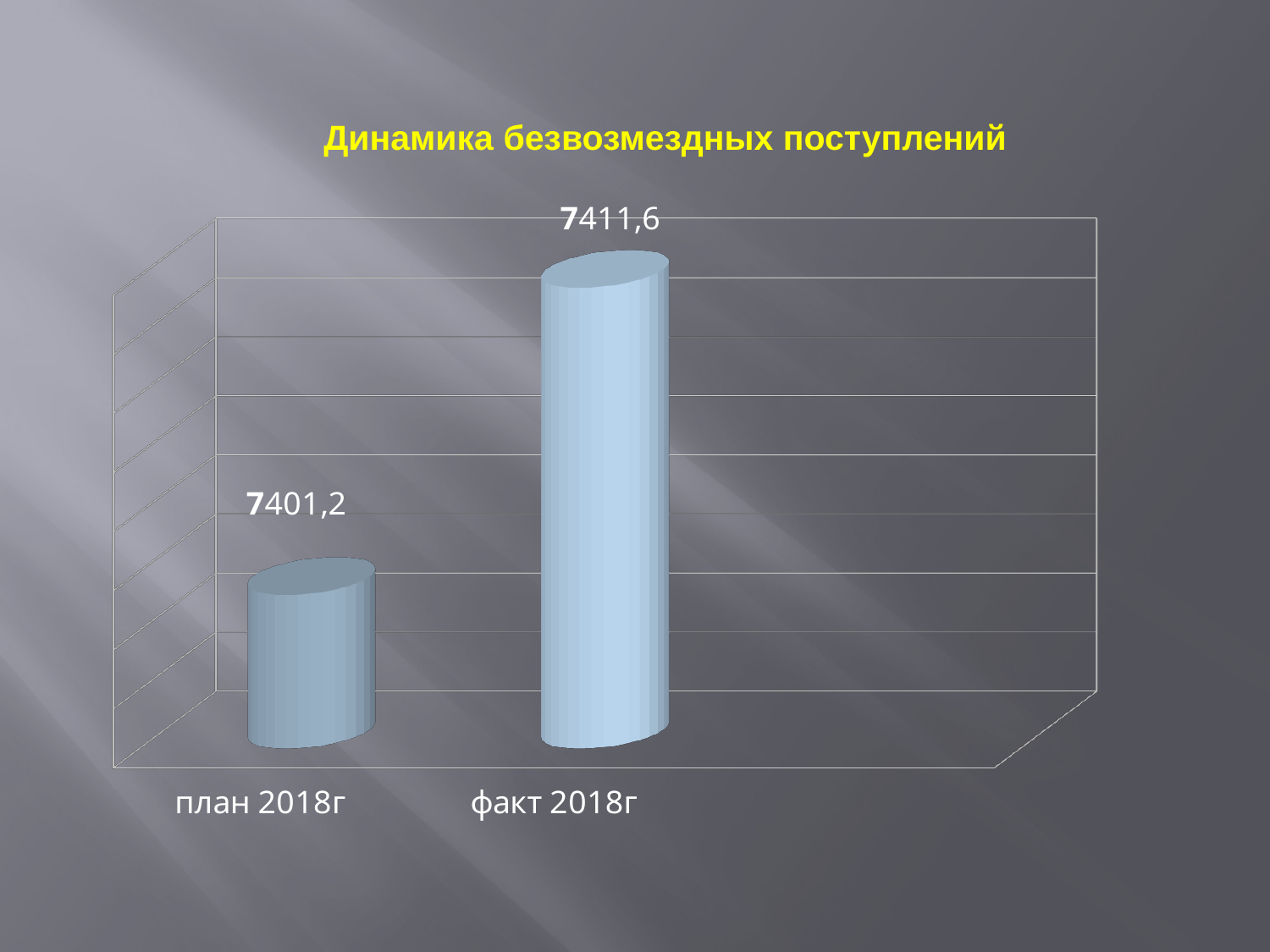
What is the label of the first category on the x axis? план 2018г What is the difference between the values for факт 2018г and план 2018г? 10,4 What is the title of the chart? Динамика безвозмездных поступлений What is the value for факт 2018г? 7411,6 Which category has the lowest value? план 2018г Which category has the highest value? факт 2018г Which is larger, the value for план 2018г or the value for факт 2018г? факт 2018г What is the value for план 2018г? 7401,2 What kind of chart is shown on the slide? bar chart Do the values rise or fall from план 2018г to факт 2018г? rise How many categories are shown in the chart? 2